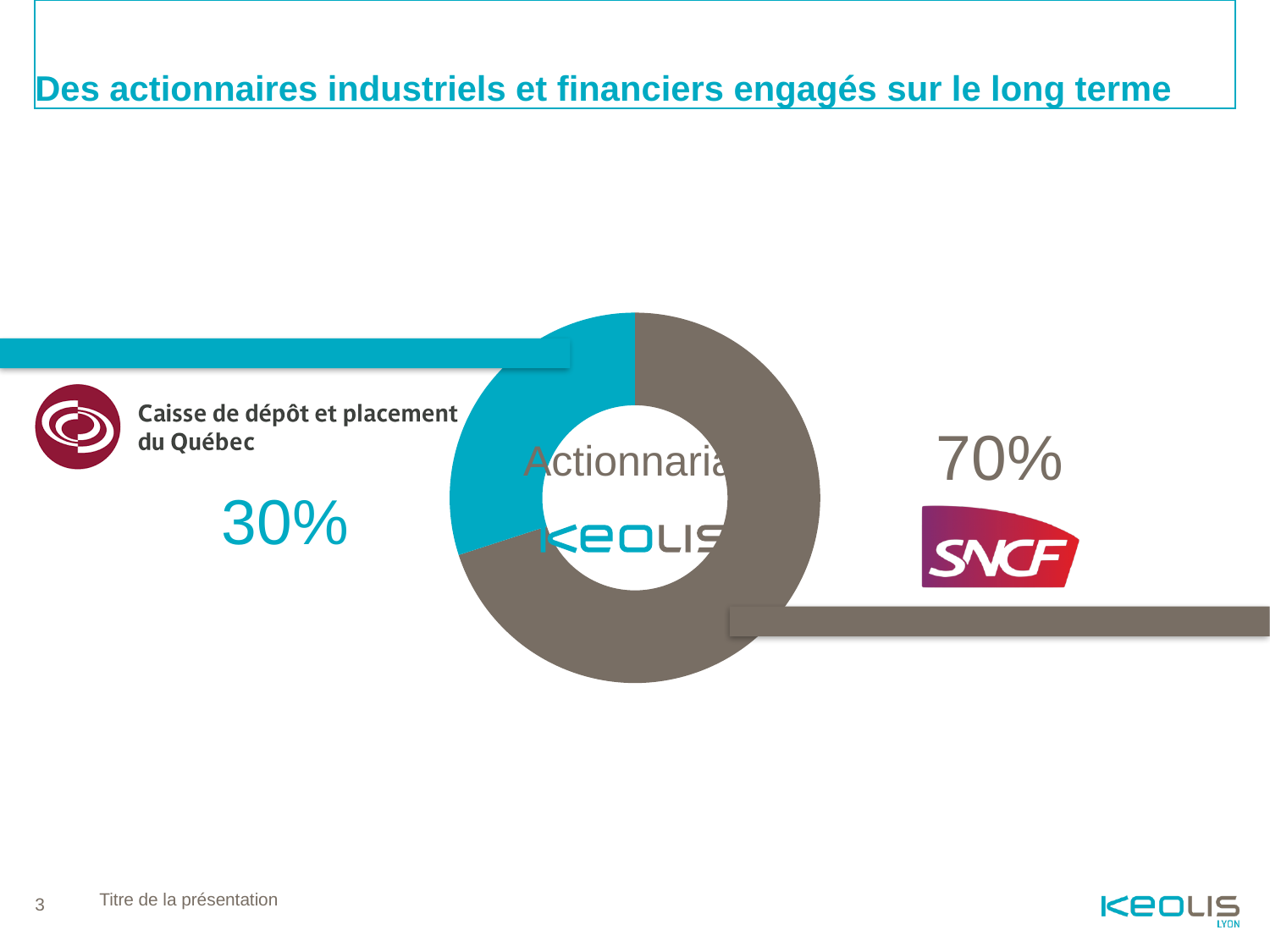
What colour is the slice representing the Caisse de dépôt et placement du Québec? Teal (blue) What kind of chart is shown on the slide? Donut (pie) chart What colour is the slice representing SNCF? Grey-brown Which is larger: SNCF's share or the Caisse de dépôt et placement du Québec's share? SNCF's share What share of Keolis does SNCF hold according to the chart? 70% Which shareholder holds the largest share in the chart? SNCF What is the total of the two shares shown in the chart? 100% What share of Keolis does the Caisse de dépôt et placement du Québec hold according to the chart? 30% How many slices does the chart have? 2 What is the difference between SNCF's share and the Caisse de dépôt et placement du Québec's share? 40% Which shareholder holds the smallest share in the chart? Caisse de dépôt et placement du Québec